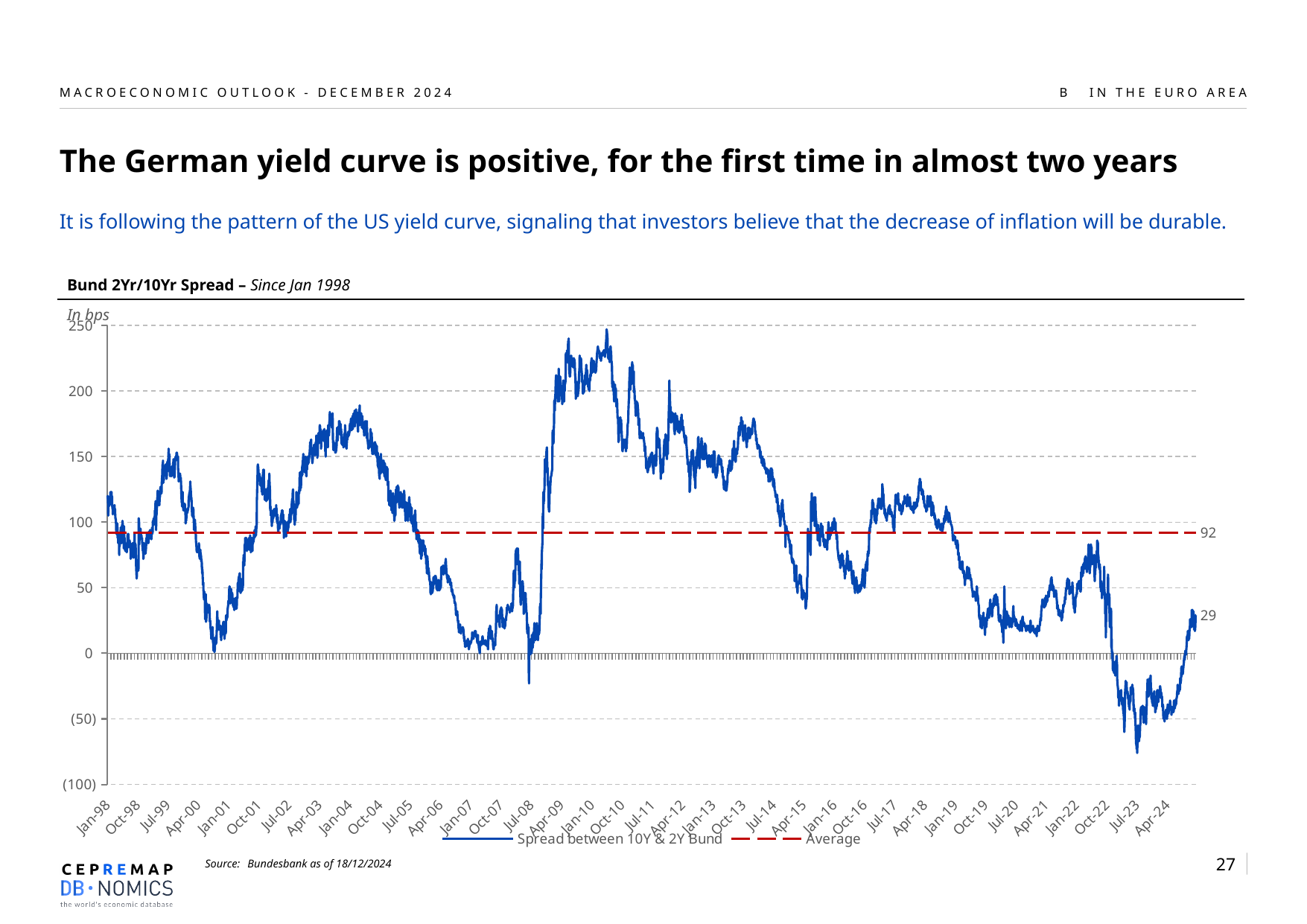
In what unit are the values on the chart expressed? bps What kind of chart is shown on the slide? line chart What is the title of the chart? Bund 2Yr/10Yr Spread – Since Jan 1998 What is the difference between the Average (92) and the latest spread value (29)? 63 Which is larger, the Average line or the latest labelled spread value? Average Is the spread around Jul-23 greater or less than 0? less Is the spread around Jan-10 greater or less than 200? greater Does the spread rise or fall between Jul-23 and the end of the series? rise What is the value of the Average line shown on the chart? 92 How many series does the legend list? 2 Is the spread at Jan-98 greater or less than 150? less What is the latest labelled value of the spread between 10Y & 2Y Bund? 29